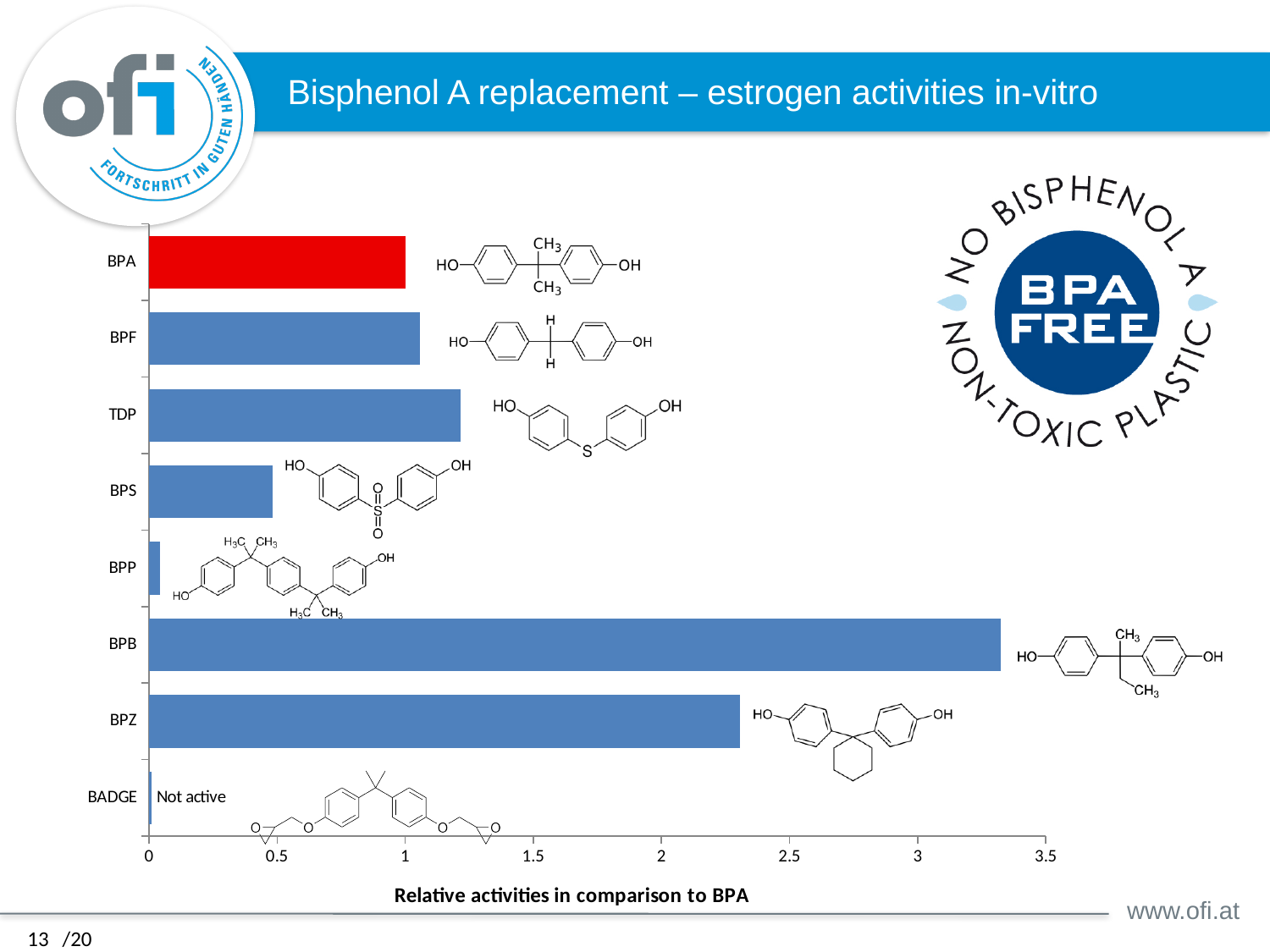
Is the relative activity for BPP greater or less than 0.5? less What kind of chart is shown on the slide? bar chart Which has a higher relative activity, TDP or BPS? TDP Is the relative activity for BPB greater or less than 3? greater How many compounds (categories) are plotted in the bar chart? 8 Which compound has the lowest relative activity in the chart? BADGE Is the relative activity for BPZ greater or less than 2? greater What is the relative activity value for BPA? 1 What is the title of the x axis of the chart? Relative activities in comparison to BPA Which compound has the highest relative activity in comparison to BPA? BPB Which has a higher relative activity, BPB or BPZ? BPB